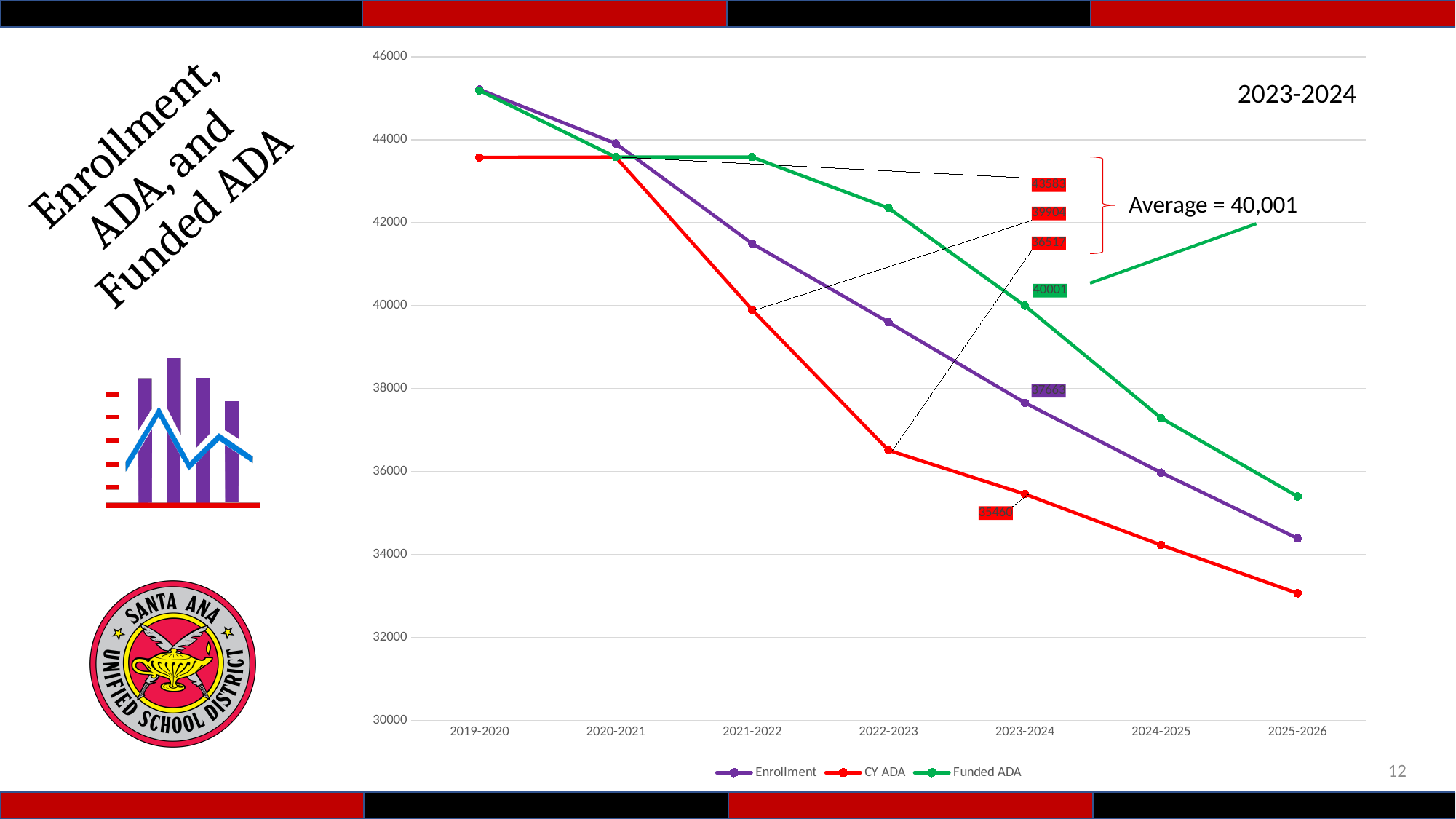
What is the CY ADA value for 2023-2024? 35460 How many series does the legend list? 3 Which series has the highest value in 2025-2026? Funded ADA Which series has the lowest value in 2023-2024? CY ADA What is the Funded ADA value for 2023-2024? 40001 How many school years are shown on the x axis? 7 What is the difference between Funded ADA and Enrollment in 2023-2024? 2338 What kind of chart is shown on the slide? line chart What is the Enrollment value for 2023-2024? 37663 In 2022-2023, which is larger: Enrollment or CY ADA? Enrollment Is the CY ADA value for 2025-2026 greater or less than 34000? less Does Enrollment rise or fall from 2019-2020 to 2025-2026? fall